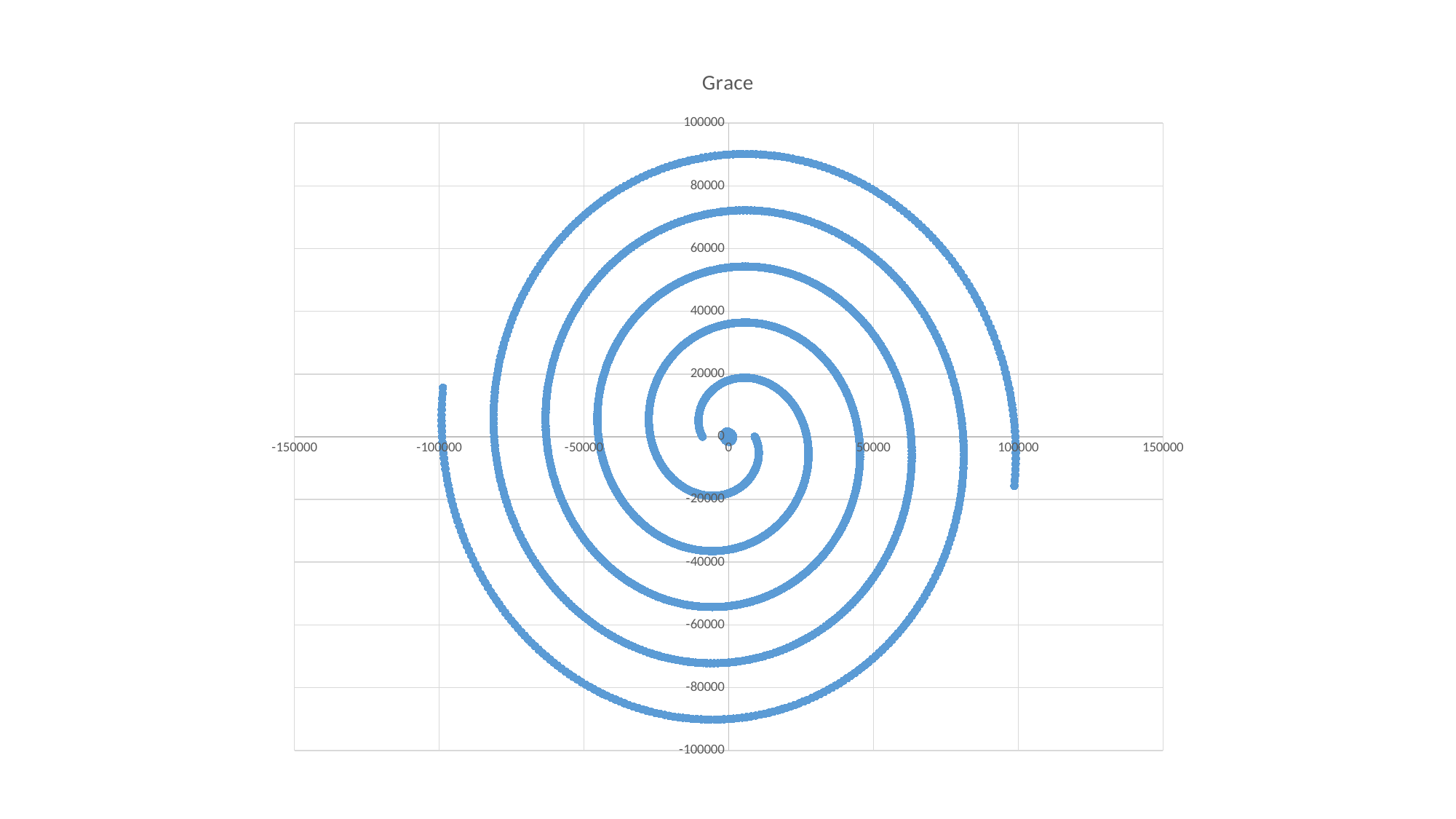
Is the lowest y value reached by the plotted points greater or less than -100000? greater Is the highest y value reached by the plotted points greater or less than 100000? less What colour are the plotted points in the chart? blue What is the title of the chart? Grace Is the bottommost point of the outer loop of the spiral greater or less than -80000 on the vertical axis? less What kind of chart is shown on the slide? scatter chart